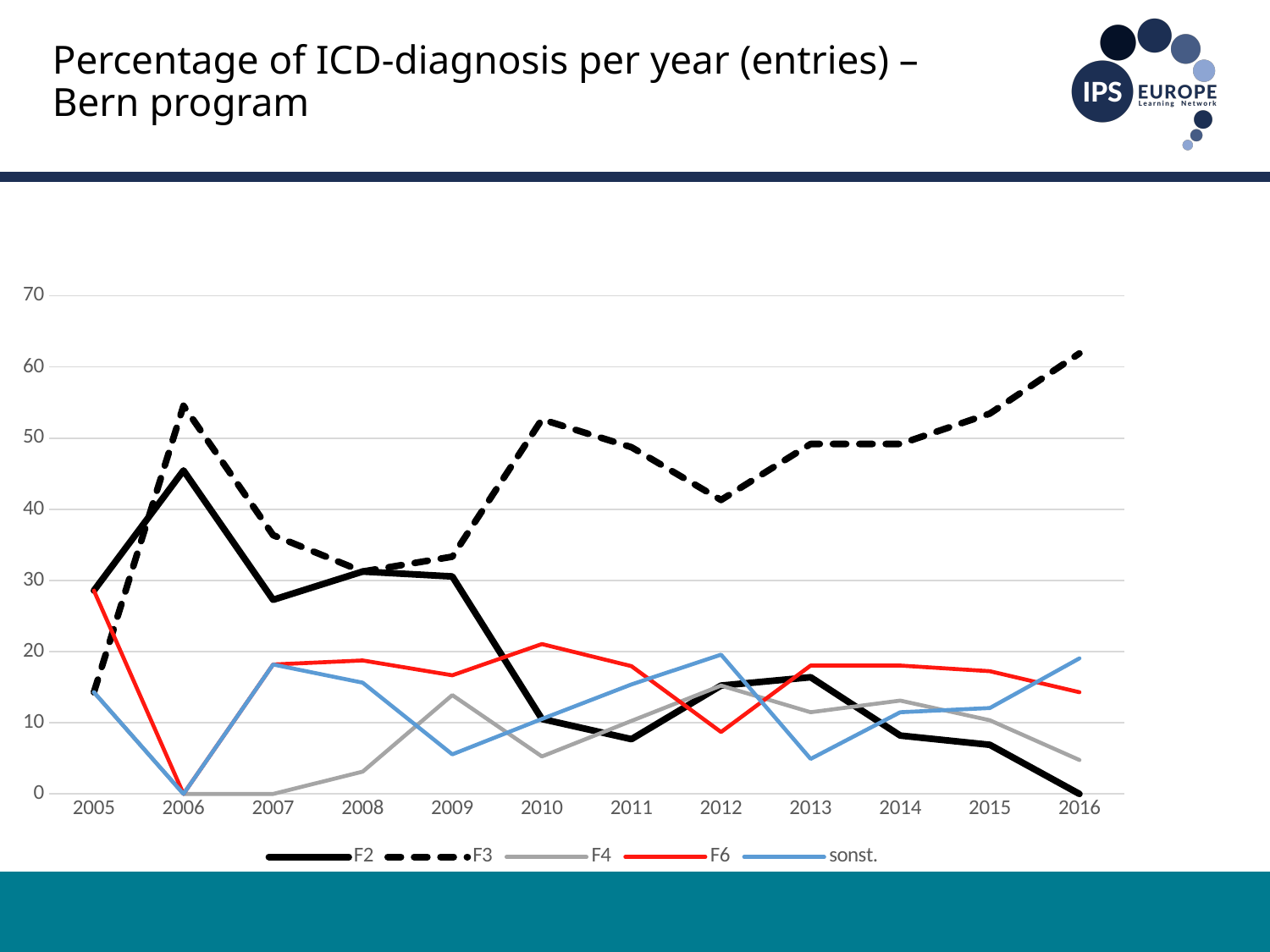
What is the value for F2 in 2016? 0 Which is larger in 2013, F6 or sonst.? F6 How many series does the legend list? 5 How many years are shown on the x axis? 12 What is the value for F6 in 2006? 0 Is the value for F2 in 2006 greater or less than 40? greater Which series has the lowest value in 2016? F2 In which year does F3 reach its highest value? 2016 Which series has the highest value in 2016? F3 Is the value for sonst. in 2013 greater or less than 10? less What kind of chart is shown on the slide? line chart Does the F3 line rise or fall from 2012 to 2016? rise